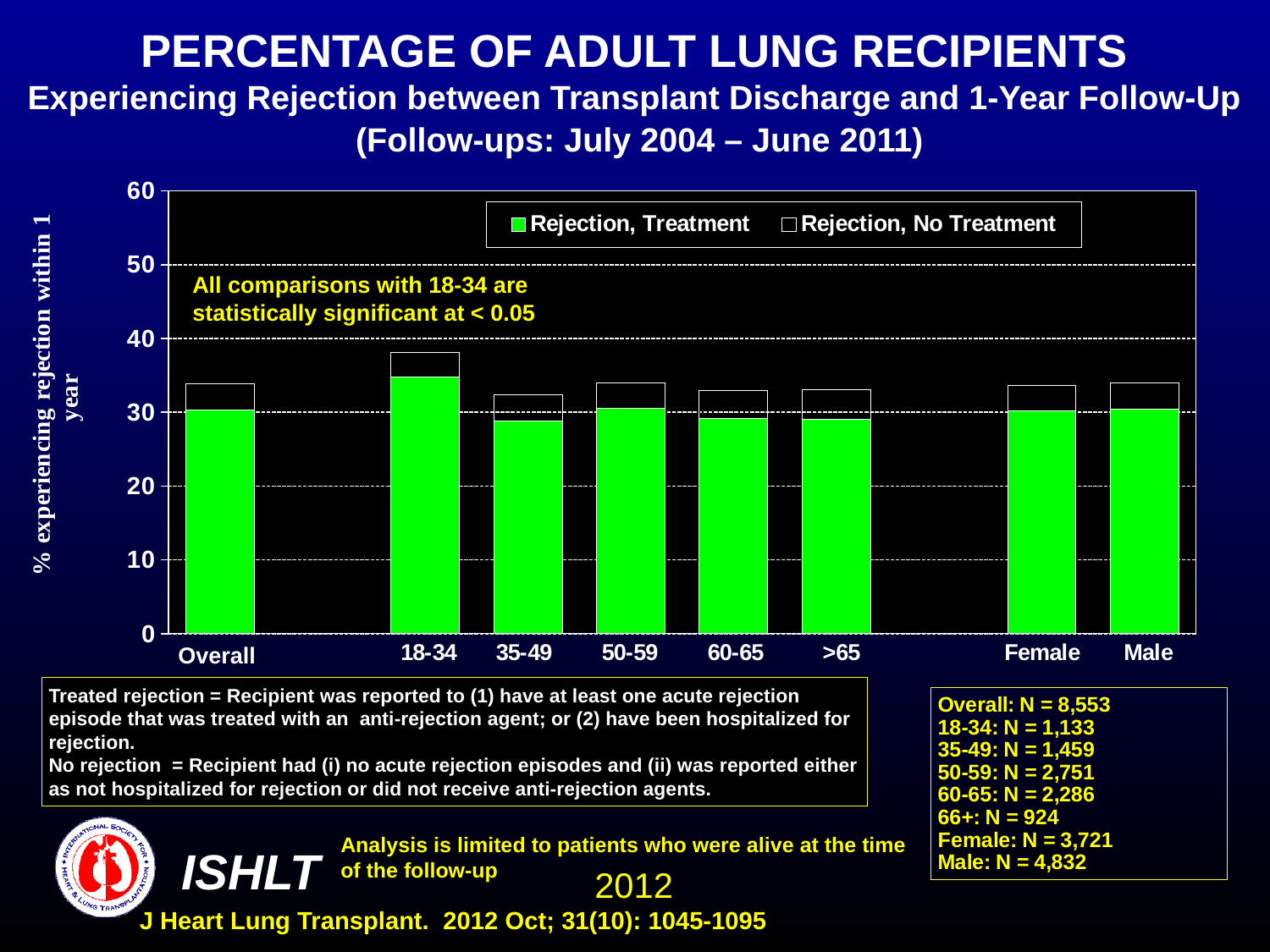
What kind of chart is shown on the slide? stacked bar chart According to the annotation on the chart, comparisons with which age group are statistically significant at < 0.05? 18-34 Is the Rejection, Treatment value for 18-34 greater or less than 30? greater Which category has the tallest stacked bar overall? 18-34 What are the two legend entries of the chart? Rejection, Treatment; Rejection, No Treatment How many series does the legend list? 2 Is the total stacked bar for Overall greater or less than 30? greater Which category has the highest value for Rejection, Treatment? 18-34 Is the total stacked bar for 18-34 greater or less than 40? less How many categories are shown along the x axis? 8 Which has the larger Rejection, Treatment value, 18-34 or 35-49? 18-34